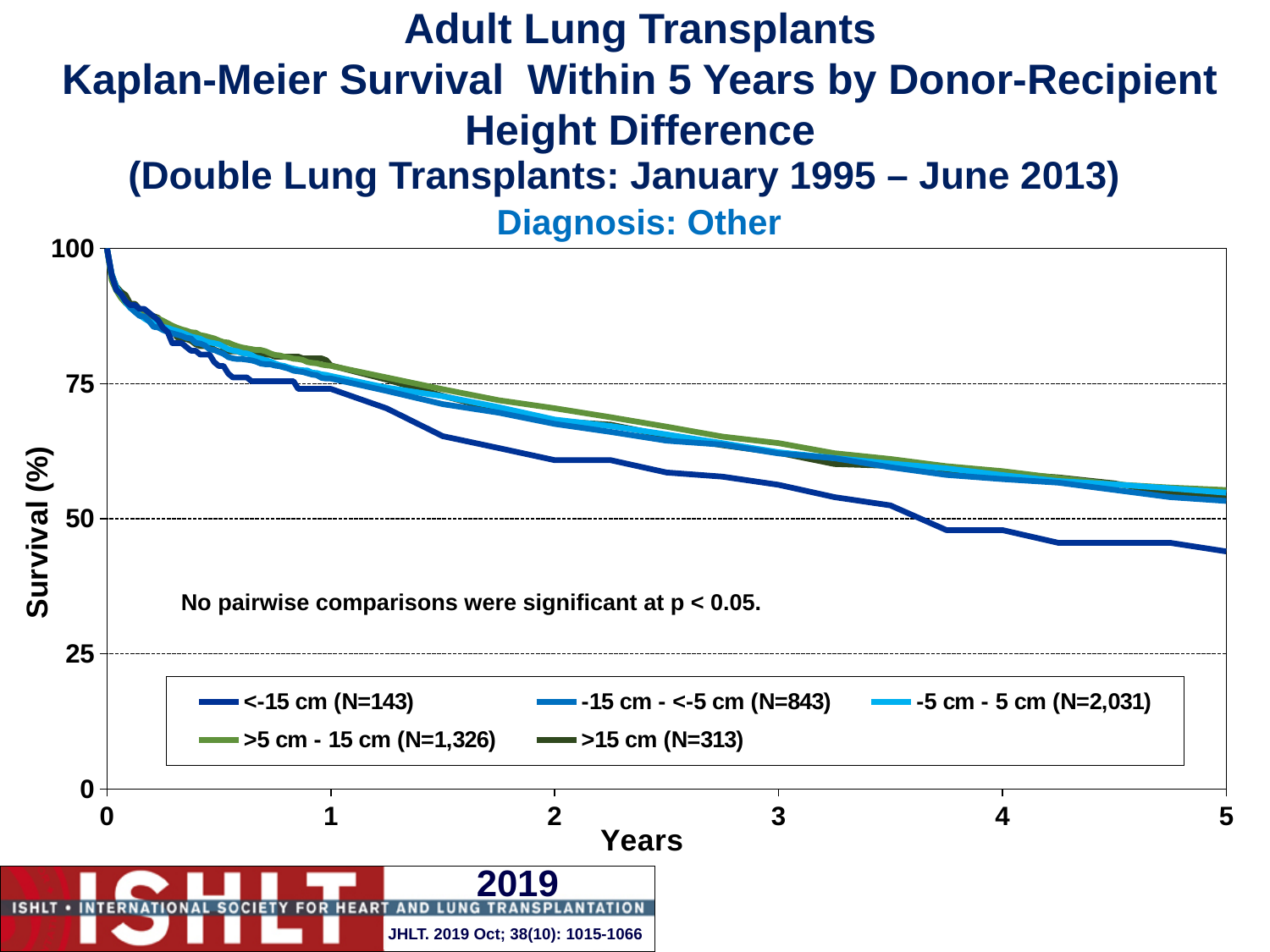
What is the survival value for all groups at year 0? 100 Which height-difference group has the lowest survival at 5 years? <-15 cm (N=143) Do the survival curves rise or fall as years increase? fall How many patients (N) are in the -5 cm - 5 cm group according to the legend? 2,031 Is the survival for the -5 cm - 5 cm group at 2 years greater or less than 75? less At 3 years, which group has higher survival: <-15 cm or -5 cm - 5 cm? -5 cm - 5 cm Is the survival for the <-15 cm group at 5 years greater or less than 50? less What kind of chart is shown on the slide? line chart How many series does the legend list? 5 What diagnosis group does the chart cover, as stated in the subtitle? Other Is the survival for the >5 cm - 15 cm group at 5 years greater or less than 50? greater